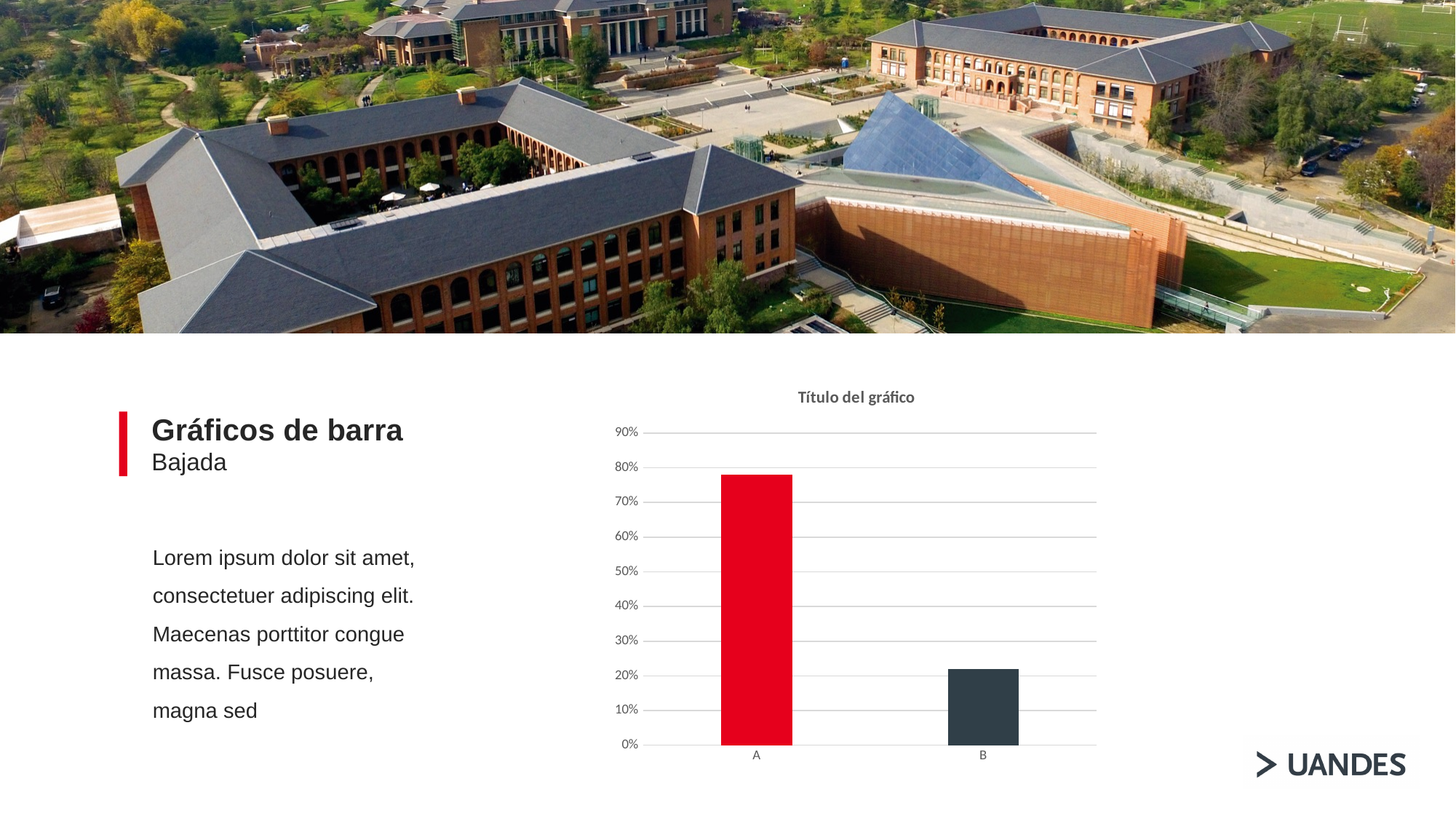
What kind of chart is shown on the slide? bar chart Is the value for B greater or less than 30%? less What is the title of the chart? Título del gráfico Which category has the highest bar in the chart? A Is the value for A greater or less than 70%? greater Do the values rise or fall from A to B along the x axis? fall What colour is the bar for category A? red Which is larger, the value for A or the value for B? A How many categories are plotted on the x axis of the chart? 2 Which category has the lowest bar in the chart? B Is the value for B greater or less than 10%? greater